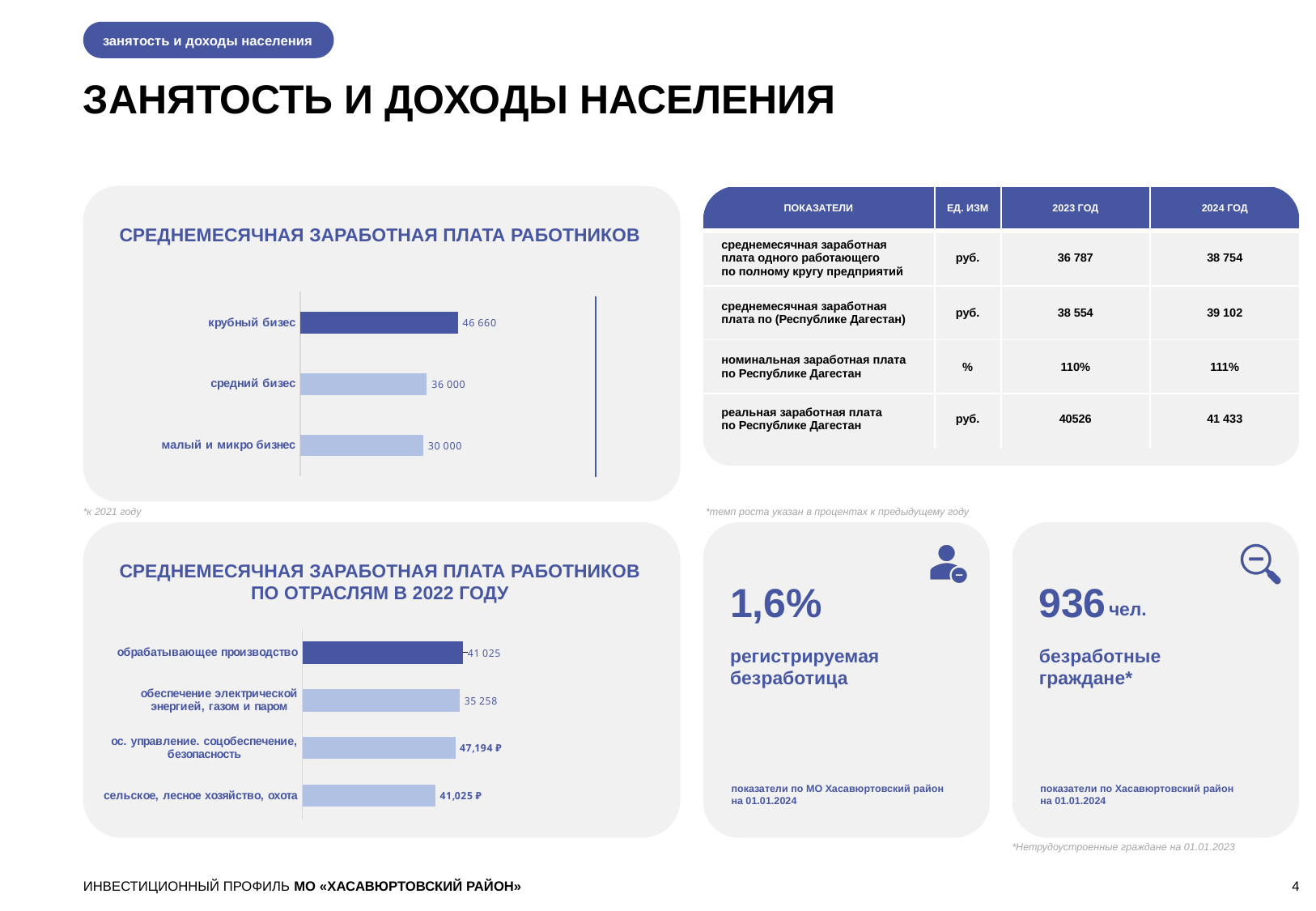
In the chart titled "СРЕДНЕМЕСЯЧНАЯ ЗАРАБОТНАЯ ПЛАТА РАБОТНИКОВ", which category has the lowest value? малый и микро бизнес In the chart titled "СРЕДНЕМЕСЯЧНАЯ ЗАРАБОТНАЯ ПЛАТА РАБОТНИКОВ", what is the value for малый и микро бизнес? 30 000 In the chart titled "СРЕДНЕМЕСЯЧНАЯ ЗАРАБОТНАЯ ПЛАТА РАБОТНИКОВ ПО ОТРАСЛЯМ В 2022 ГОДУ", how many categories are shown? 4 In the chart titled "СРЕДНЕМЕСЯЧНАЯ ЗАРАБОТНАЯ ПЛАТА РАБОТНИКОВ", which category has the highest value? крубный бизес What kind of chart is the one titled "СРЕДНЕМЕСЯЧНАЯ ЗАРАБОТНАЯ ПЛАТА РАБОТНИКОВ"? bar chart In the chart titled "СРЕДНЕМЕСЯЧНАЯ ЗАРАБОТНАЯ ПЛАТА РАБОТНИКОВ", how many categories are shown? 3 In the chart titled "СРЕДНЕМЕСЯЧНАЯ ЗАРАБОТНАЯ ПЛАТА РАБОТНИКОВ ПО ОТРАСЛЯМ В 2022 ГОДУ", what is the difference between the labelled values for обрабатывающее производство and обеспечение электрической энергией, газом и паром? 5 767 In the chart titled "СРЕДНЕМЕСЯЧНАЯ ЗАРАБОТНАЯ ПЛАТА РАБОТНИКОВ", what is the difference between крубный бизес and средний бизес? 10 660 In the chart titled "СРЕДНЕМЕСЯЧНАЯ ЗАРАБОТНАЯ ПЛАТА РАБОТНИКОВ ПО ОТРАСЛЯМ В 2022 ГОДУ", what is the value for ос. управление. соцобеспечение, безопасность? 47,194 ₽ In the chart titled "СРЕДНЕМЕСЯЧНАЯ ЗАРАБОТНАЯ ПЛАТА РАБОТНИКОВ", what is the value for крубный бизес? 46 660 In the chart titled "СРЕДНЕМЕСЯЧНАЯ ЗАРАБОТНАЯ ПЛАТА РАБОТНИКОВ ПО ОТРАСЛЯМ В 2022 ГОДУ", what is the value for обрабатывающее производство? 41 025 In the chart titled "СРЕДНЕМЕСЯЧНАЯ ЗАРАБОТНАЯ ПЛАТА РАБОТНИКОВ ПО ОТРАСЛЯМ В 2022 ГОДУ", what is the value for обеспечение электрической энергией, газом и паром? 35 258